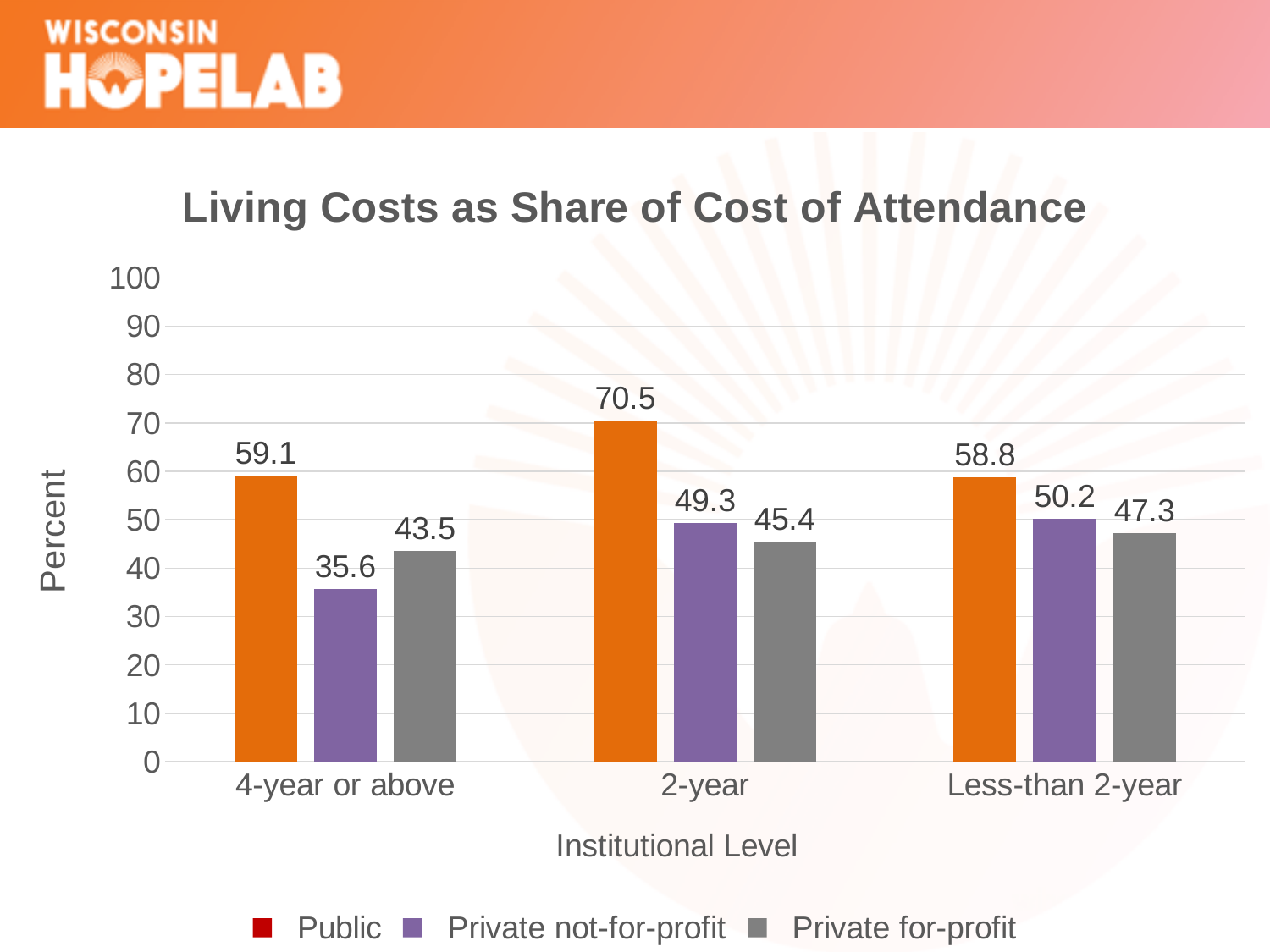
Which is larger at Less-than 2-year institutions: Private not-for-profit or Private for-profit? Private not-for-profit What is the value for Public at 2-year institutions? 70.5 What is the value for Private for-profit at Less-than 2-year institutions? 47.3 What kind of chart is shown on the slide? bar chart Which institutional level has the lowest Private not-for-profit value? 4-year or above Which institutional level has the highest Public value? 2-year How many series does the legend list? 3 What is the value for Private not-for-profit at 4-year or above institutions? 35.6 Is the Public value for 4-year or above greater or less than 50? greater What is the difference between the Public and Private for-profit values at 2-year institutions? 25.1 How many institutional levels are shown on the x axis? 3 What is the title of the chart? Living Costs as Share of Cost of Attendance